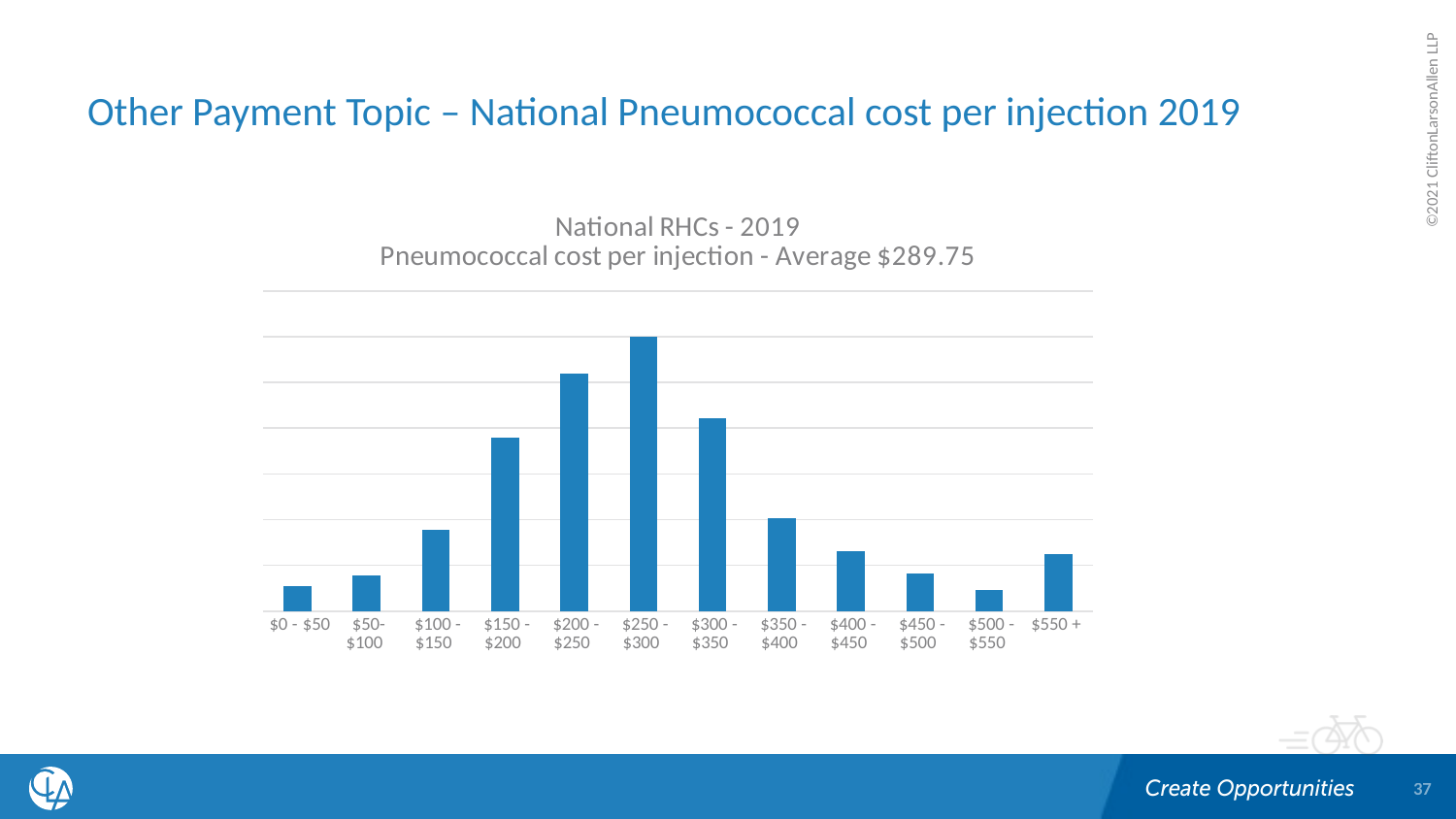
Which bar is taller: $100 - $150 or $400 - $450? $100 - $150 Which cost range has the highest bar in the chart? $250 - $300 What kind of chart is shown on the slide? Bar chart Which cost range has the lowest bar in the chart? $0 - $50 Do the bar heights rise or fall from $250 - $300 through $500 - $550? Fall Which bar is taller: $150 - $200 or $350 - $400? $150 - $200 Do the bar heights rise or fall from $0 - $50 through $250 - $300? Rise What year does the chart title say the National RHCs data is for? 2019 Which bar is taller: $550 + or $450 - $500? $550 + What average pneumococcal cost per injection is stated in the chart title? $289.75 How many cost ranges (categories) are shown on the x axis of the chart? 12